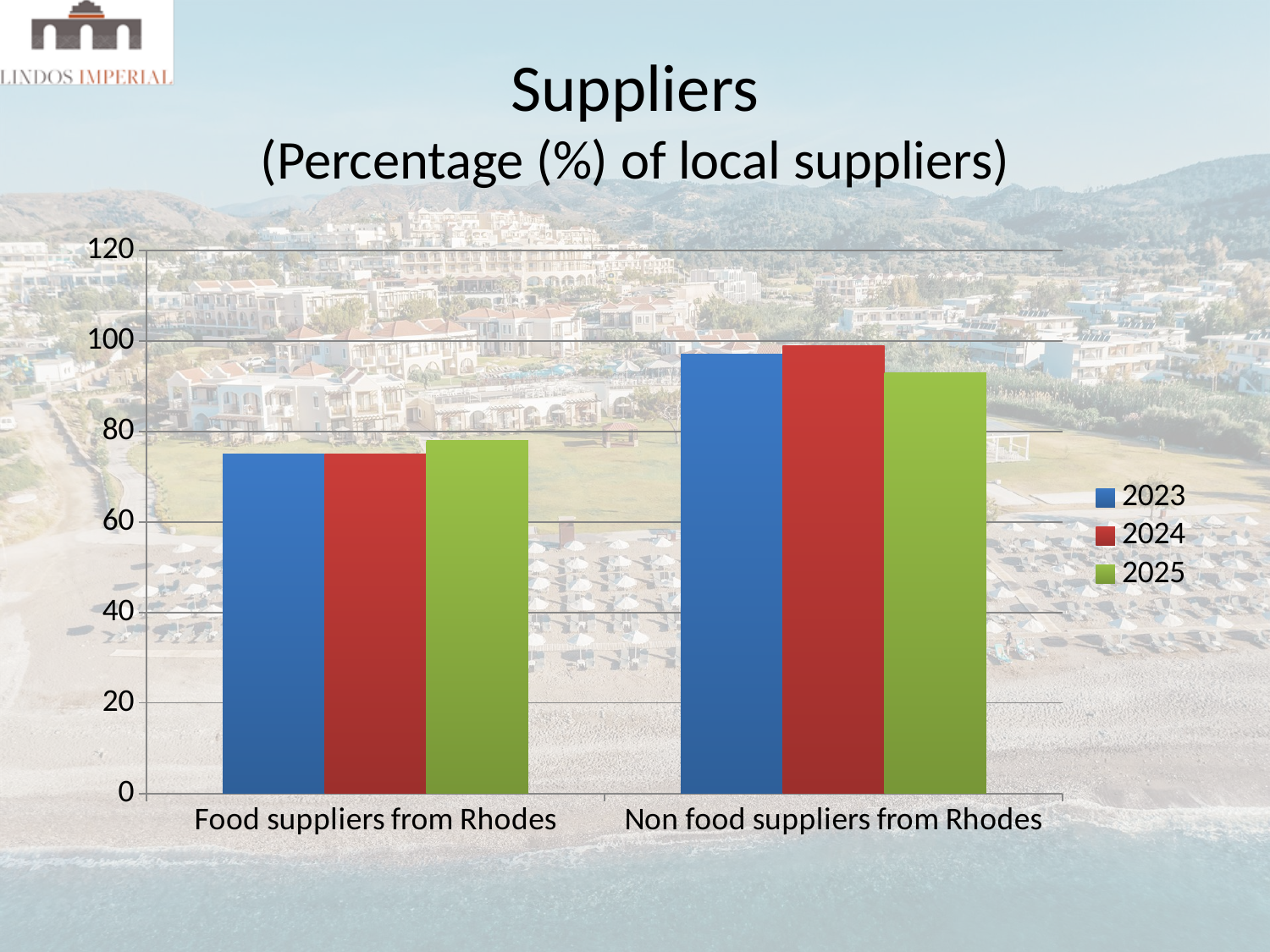
For Non food suppliers from Rhodes, which year has the lowest value? 2025 Is the value for Food suppliers from Rhodes in 2023 greater or less than 60? greater Which is larger: the 2023 value for Food suppliers from Rhodes or the 2023 value for Non food suppliers from Rhodes? Non food suppliers from Rhodes Is the value for Non food suppliers from Rhodes in 2023 greater or less than 80? greater How many categories are shown on the x axis? 2 What is the title of the chart? Suppliers (Percentage (%) of local suppliers) Which colour represents the 2024 series in the legend? red Is the value for Non food suppliers from Rhodes in 2025 greater or less than 100? less Which is larger: the 2024 value for Non food suppliers from Rhodes or the 2025 value for Non food suppliers from Rhodes? 2024 How many series does the legend list? 3 What kind of chart is shown on the slide? bar chart